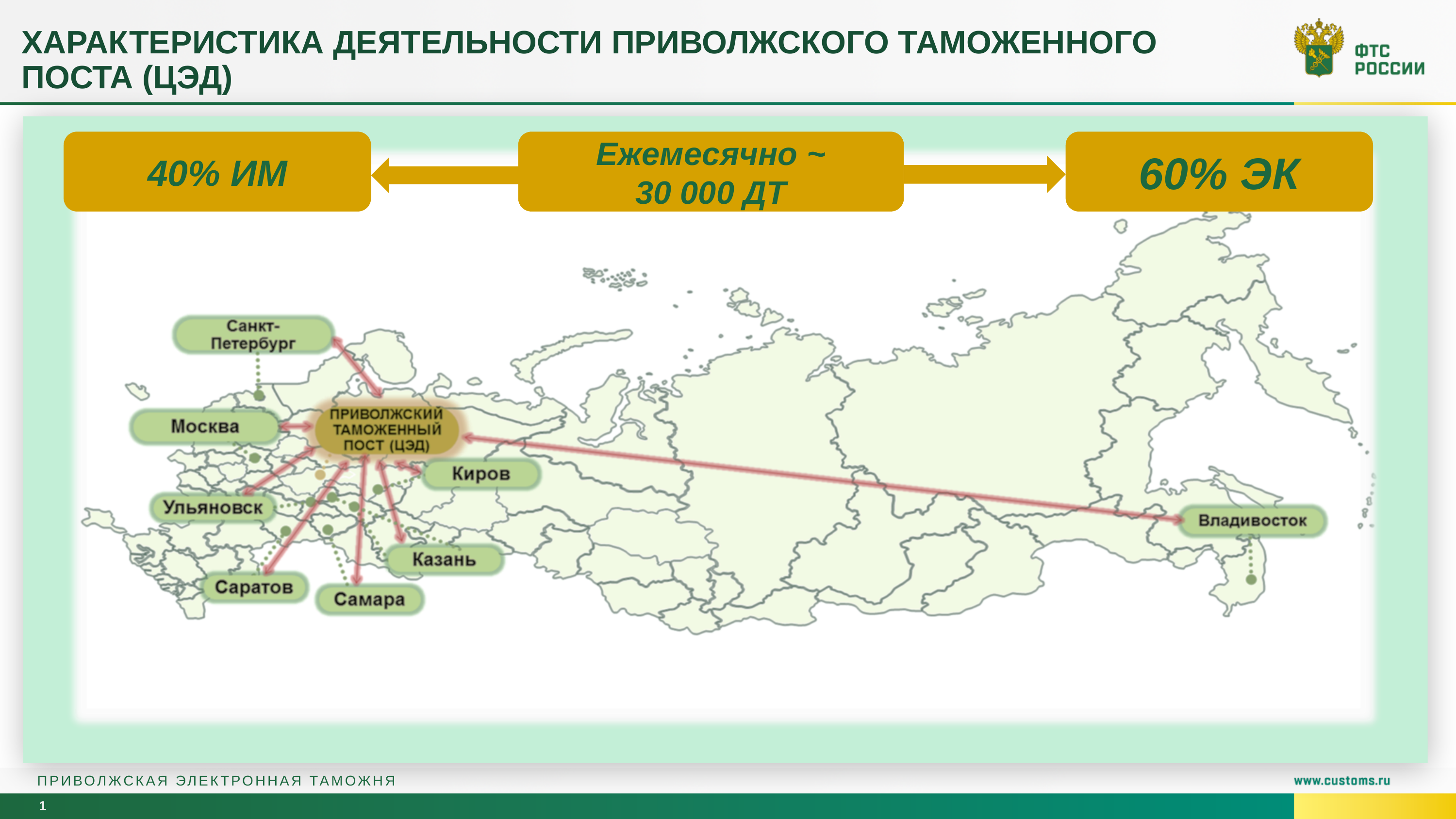
What share of declarations is marked as import (ИМ) in the diagram at the top of the slide? 40% Which labelled city on the map is farthest east from the Приволжский таможенный пост (ЦЭД)? Владивосток What is the total of the import (ИМ) and export (ЭК) shares shown in the top diagram? 100% What is the difference between the export share (ЭК) and the import share (ИМ) shown in the top diagram? 20% What share of declarations is marked as export (ЭК) in the diagram at the top of the slide? 60% What is the name of the central node on the map to which all the arrows point? Приволжский таможенный пост (ЦЭД) Which is larger in the top diagram, the import share (ИМ) or the export share (ЭК)? ЭК (60%) How many cities are labelled on the map as connected to the Приволжский таможенный пост (ЦЭД)? 8